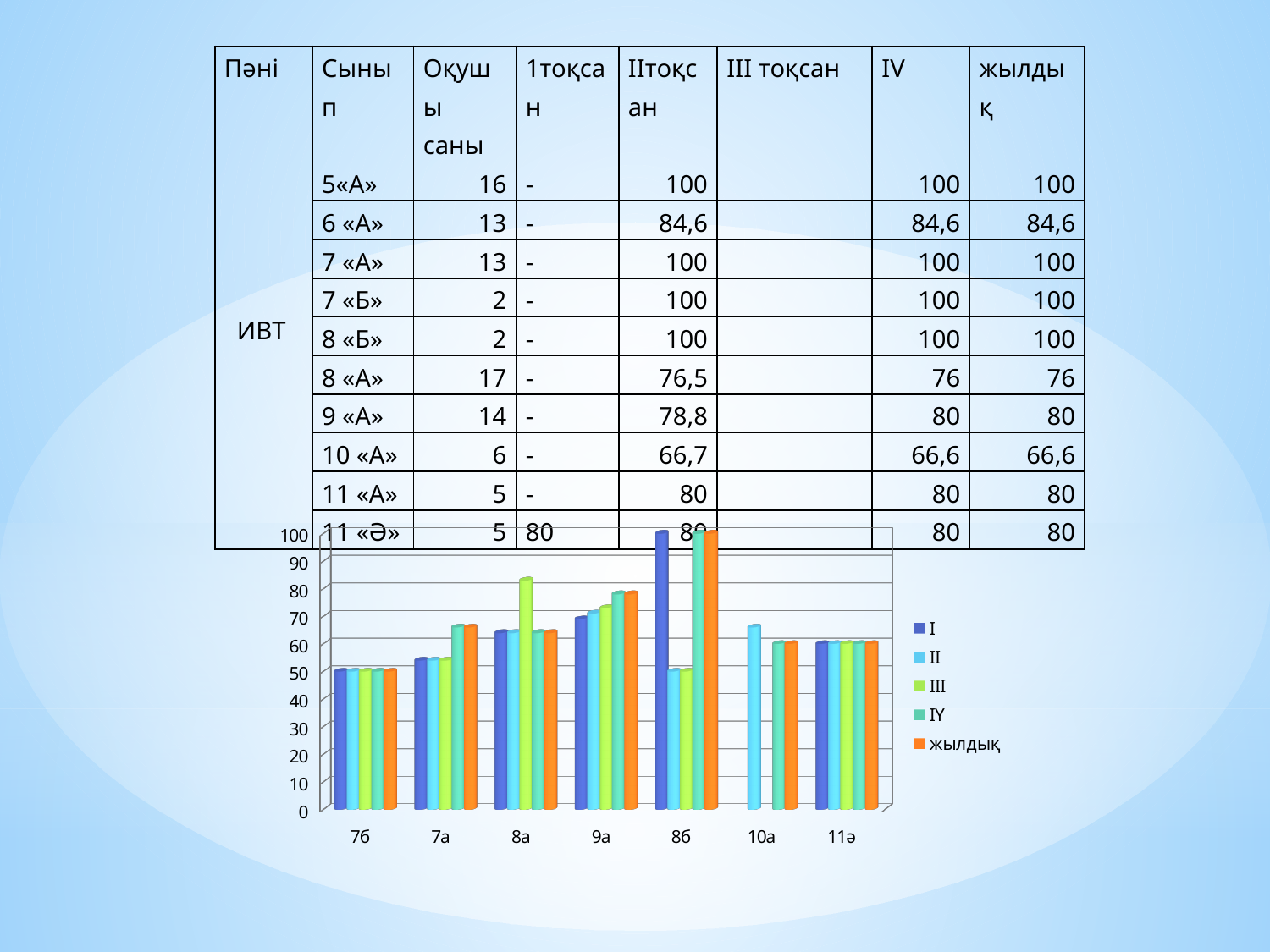
Is the value for series I in category 8б greater or less than 90? greater In category 8а, which is larger: the bar for series III or the bar for series I? series III Is the value for series I in category 7б greater or less than 60? less How many series does the chart legend list? 5 Which category has the tallest bar for series III? 8а Which category has the tallest bar for series I? 8б In category 8б, which is larger: the bar for series I or the bar for series II? series I Is the value for series IY in category 9а greater or less than 70? greater What kind of chart is shown on the slide? bar chart How many categories are shown along the x axis of the chart? 7 What is the last entry in the chart legend? жылдық